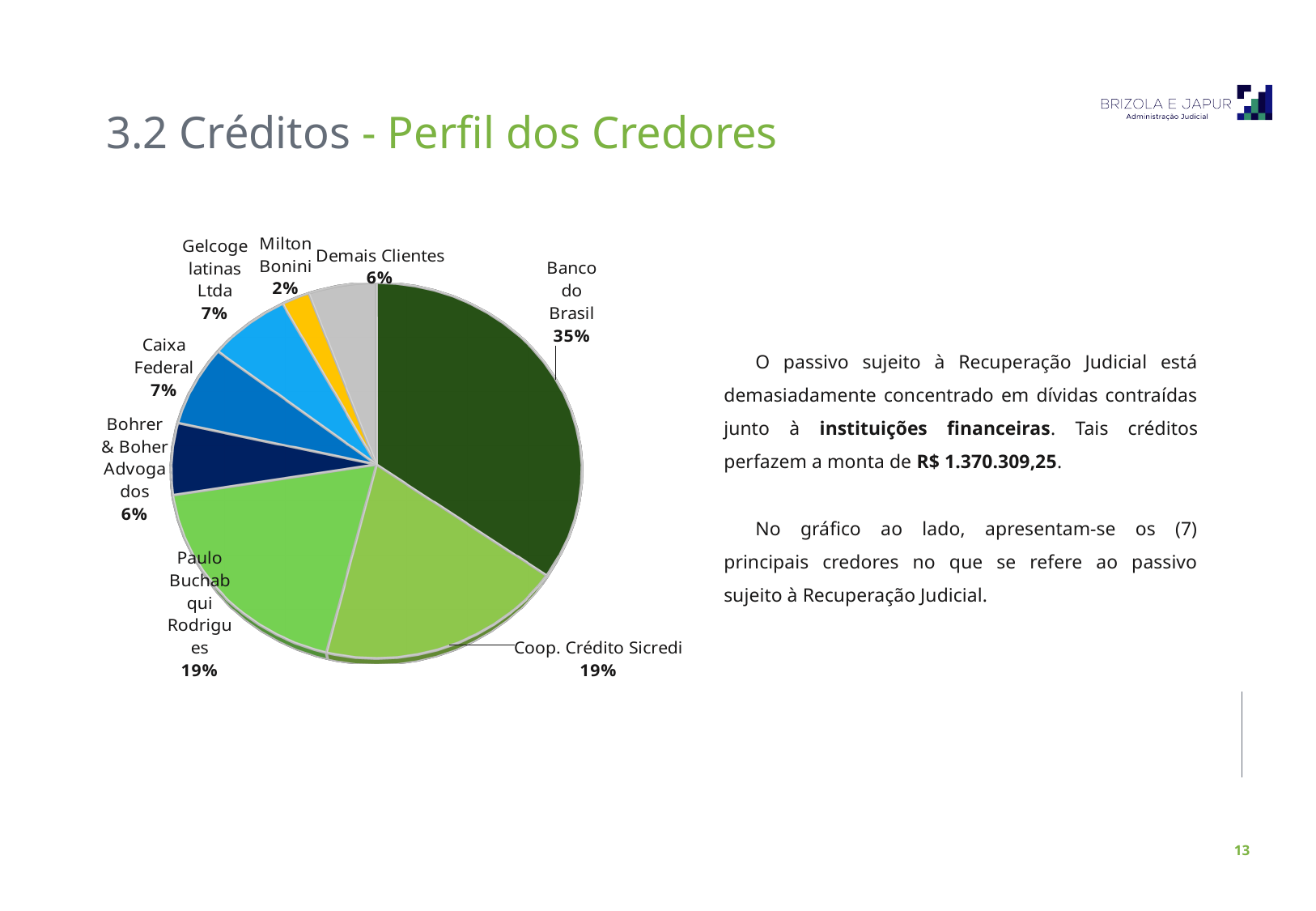
What share of the pie does Banco do Brasil hold? 35% What colour is the Banco do Brasil slice? Dark green Which slice of the pie is the smallest? Milton Bonini What is the difference in percentage points between Banco do Brasil and Paulo Buchabqui Rodrigues? 16 percentage points What share of the pie does Coop. Crédito Sicredi hold? 19% What percentage is shown for Caixa Federal? 7% What percentage is shown for Milton Bonini? 2% Which is larger, the share for Gelcogelatinas Ltda or the share for Bohrer & Boher Advogados? Gelcogelatinas Ltda What kind of chart is shown on the slide? Pie chart What percentage is shown for Demais Clientes? 6% How many slices does the pie chart have? 8 Which slice of the pie is the largest? Banco do Brasil